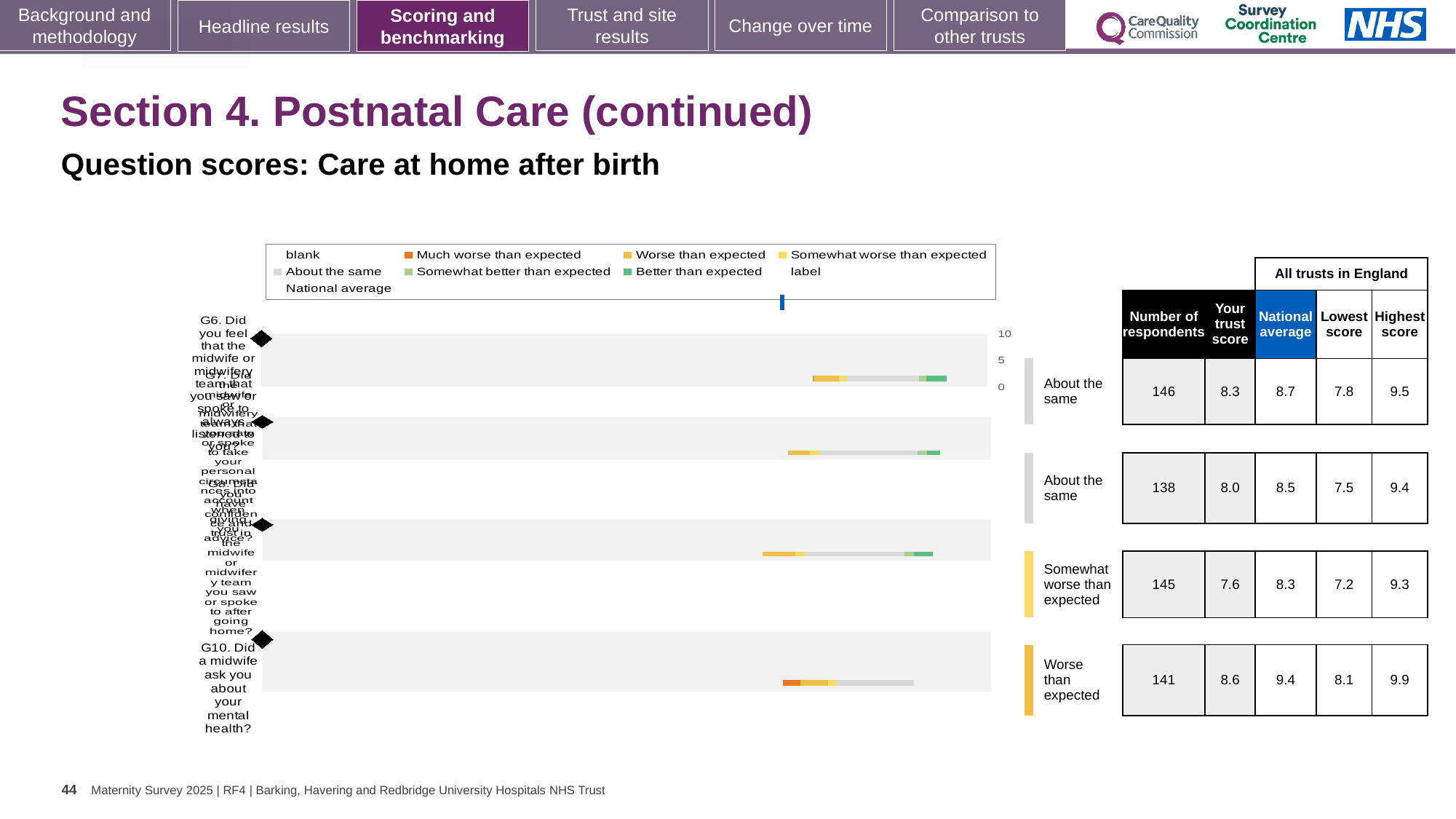
How many of the question rows are rated 'About the same'? 2 How many question rows (bars) does the chart show? 4 What benchmark category is given for G10 (Did a midwife ask you about your mental health?)? Worse than expected What kind of chart is shown on the slide? bar chart What is the lowest 'Your trust score' value shown in the table? 7.6 For G10 (Did a midwife ask you about your mental health?), what is the national average? 9.4 How many respondents are listed for G10 (Did a midwife ask you about your mental health?)? 141 What is the heading above the chart describing the question scores? Question scores: Care at home after birth Which question row has the highest 'Your trust score' in the table? G10. Did a midwife ask you about your mental health? What is the highest score across all trusts in England for G10 (Did a midwife ask you about your mental health?)? 9.9 For G10 (Did a midwife ask you about your mental health?), what is the trust score shown in the table? 8.6 For G10, how much higher is the national average than the trust score? 0.8